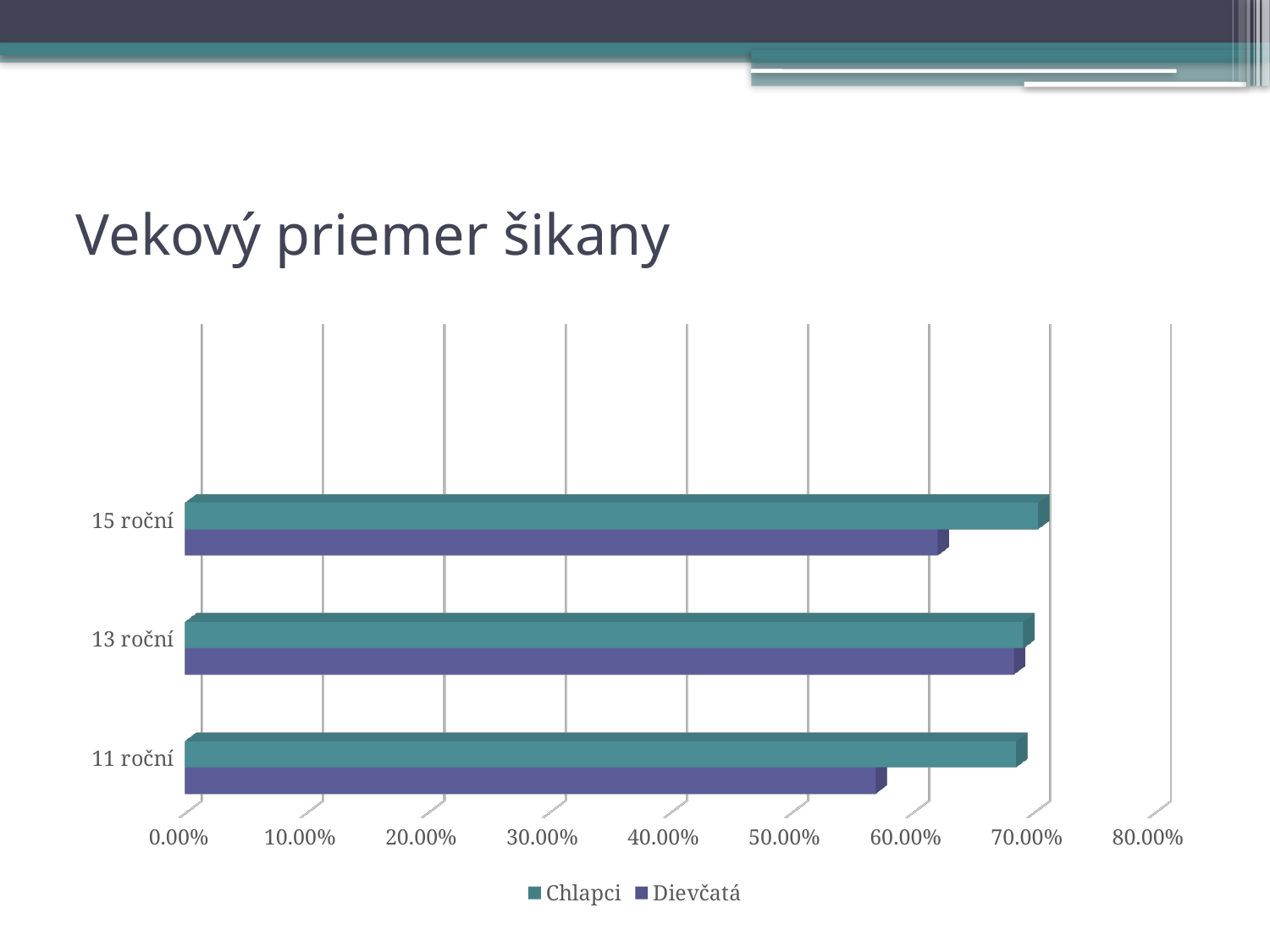
For the Dievčatá series, which age category has the lowest value? 11 roční In the 11 roční category, which is larger: Chlapci or Dievčatá? Chlapci Is the value for Dievčatá in the 11 roční category greater or less than 60.00%? less In the 15 roční category, which is larger: Chlapci or Dievčatá? Chlapci How many age categories are shown on the chart? 3 Is the value for Dievčatá in the 13 roční category greater or less than 60.00%? greater What is the title of the chart on the slide? Vekový priemer šikany Which two series are listed in the legend? Chlapci and Dievčatá Is the value for Dievčatá in the 15 roční category greater or less than 60.00%? greater What kind of chart is shown on the slide? bar chart How many series does the legend list? 2